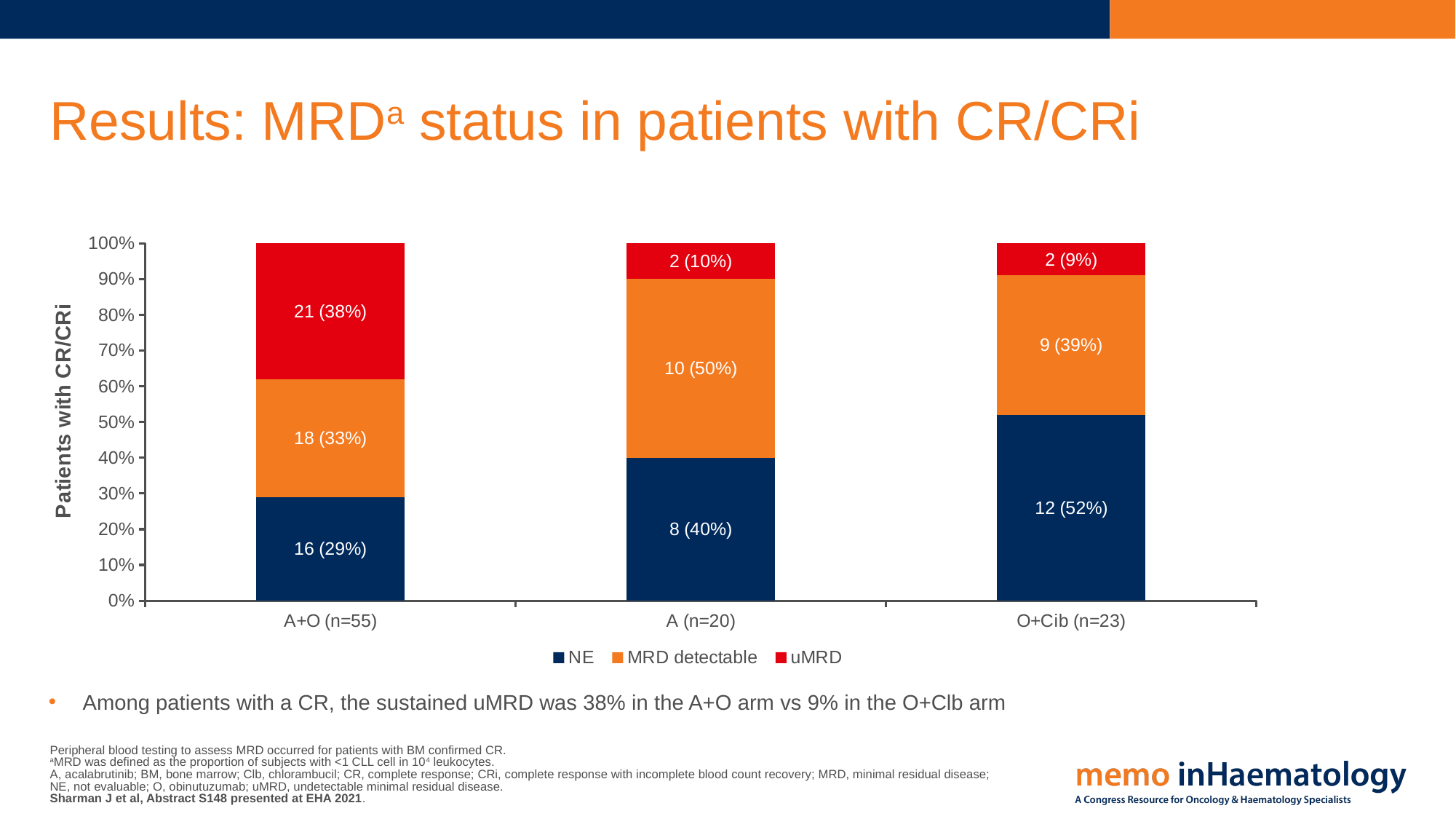
What is the title of the y axis? Patients with CR/CRi What kind of chart is shown on the slide? Stacked bar chart Which treatment arm has the lowest number of NE patients? A (n=20) What is the total number of patients across the three segments of the A+O (n=55) bar? 55 How many more uMRD patients are in the A+O (n=55) arm than in the O+Clb (n=23) arm? 19 Which arm has more MRD detectable patients, A+O (n=55) or A (n=20)? A+O (n=55) How many treatment arms are shown on the x axis? 3 What is the data label for the MRD detectable segment of the O+Clb (n=23) bar? 9 (39%) What is the data label for the uMRD segment of the A+O (n=55) bar? 21 (38%) Which treatment arm has the highest number of uMRD patients? A+O (n=55) How many series does the legend list? 3 What is the data label for the NE segment of the A (n=20) bar? 8 (40%)